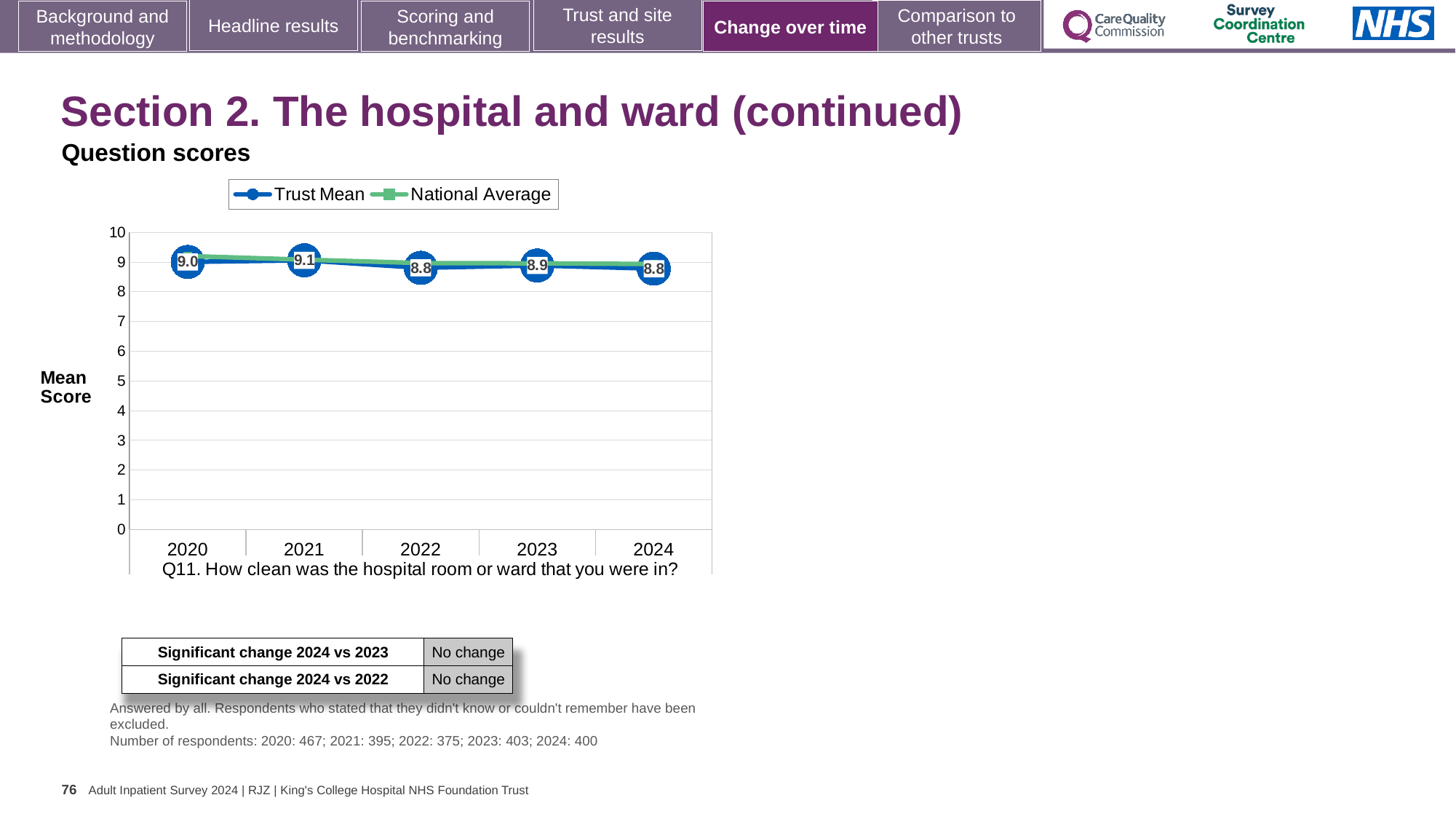
What kind of chart is shown on the slide? Line chart What is the Trust Mean value for 2024? 8.8 What is the difference between the Trust Mean in 2021 and in 2022? 0.3 What is the Trust Mean value for 2020? 9.0 Is the National Average value for 2020 greater or less than 8? greater What is the title of the y axis? Mean Score Does the Trust Mean rise or fall overall from 2020 to 2024? Fall In which year is the Trust Mean highest? 2021 How many years are plotted on the x axis? 5 What is the Trust Mean value for 2021? 9.1 How many series does the legend list? 2 Which year has the larger Trust Mean, 2021 or 2022? 2021